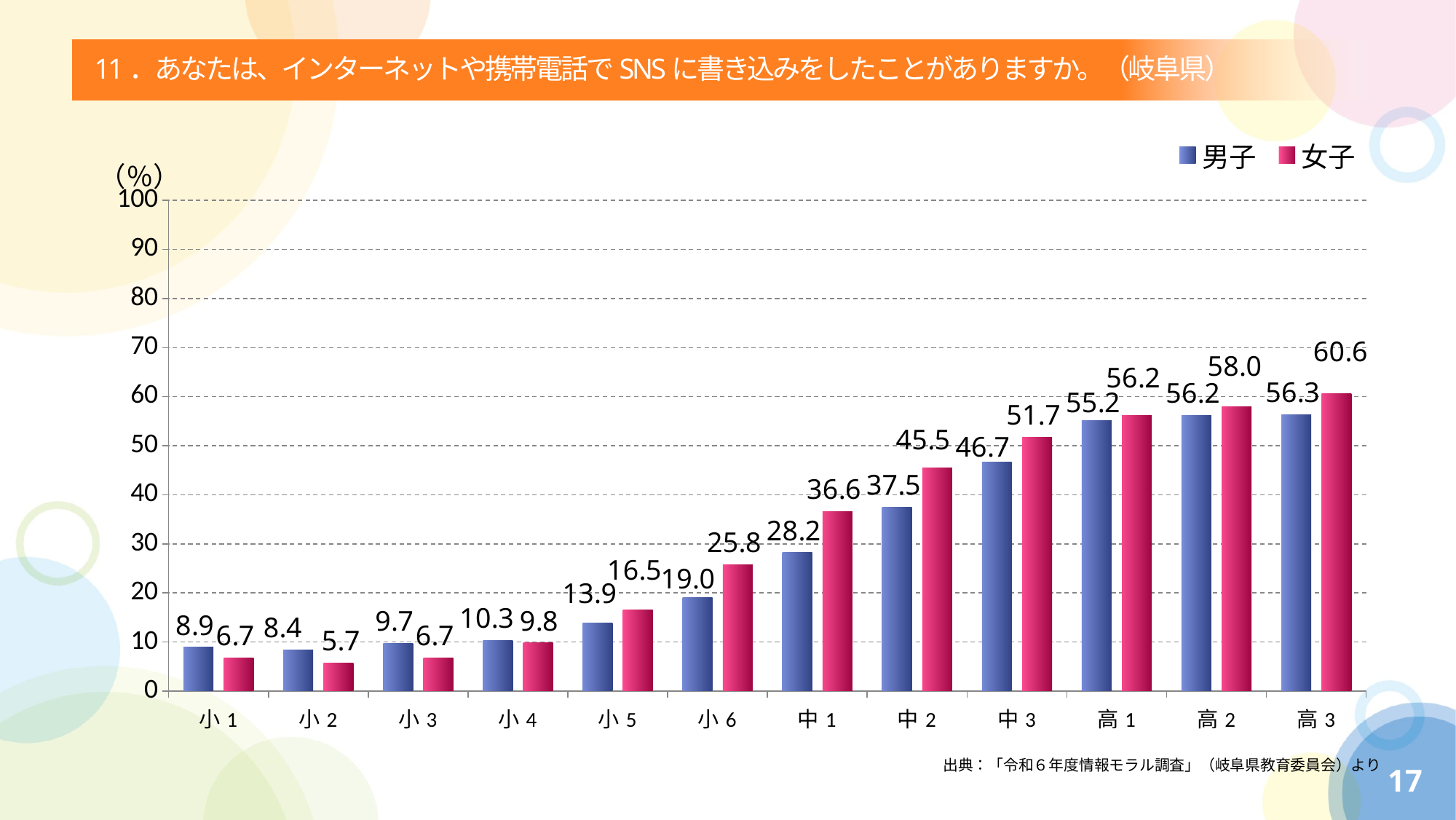
Which is larger at 小1, the 男子 value or the 女子 value? 男子 What is the value for 男子 at 中1? 28.2 What is the value for 女子 at 高3? 60.6 Which category has the highest value for 女子? 高3 Do the 女子 values generally rise or fall from 小3 to 高3? rise How many series does the legend list? 2 Is the value for 男子 at 中3 greater or less than 40? greater How many categories are shown on the x axis? 12 Which category has the lowest value for 女子? 小2 What is the value for 女子 at 小2? 5.7 What kind of chart is shown on the slide? bar chart What is the difference between the 女子 and 男子 values at 中2? 8.0